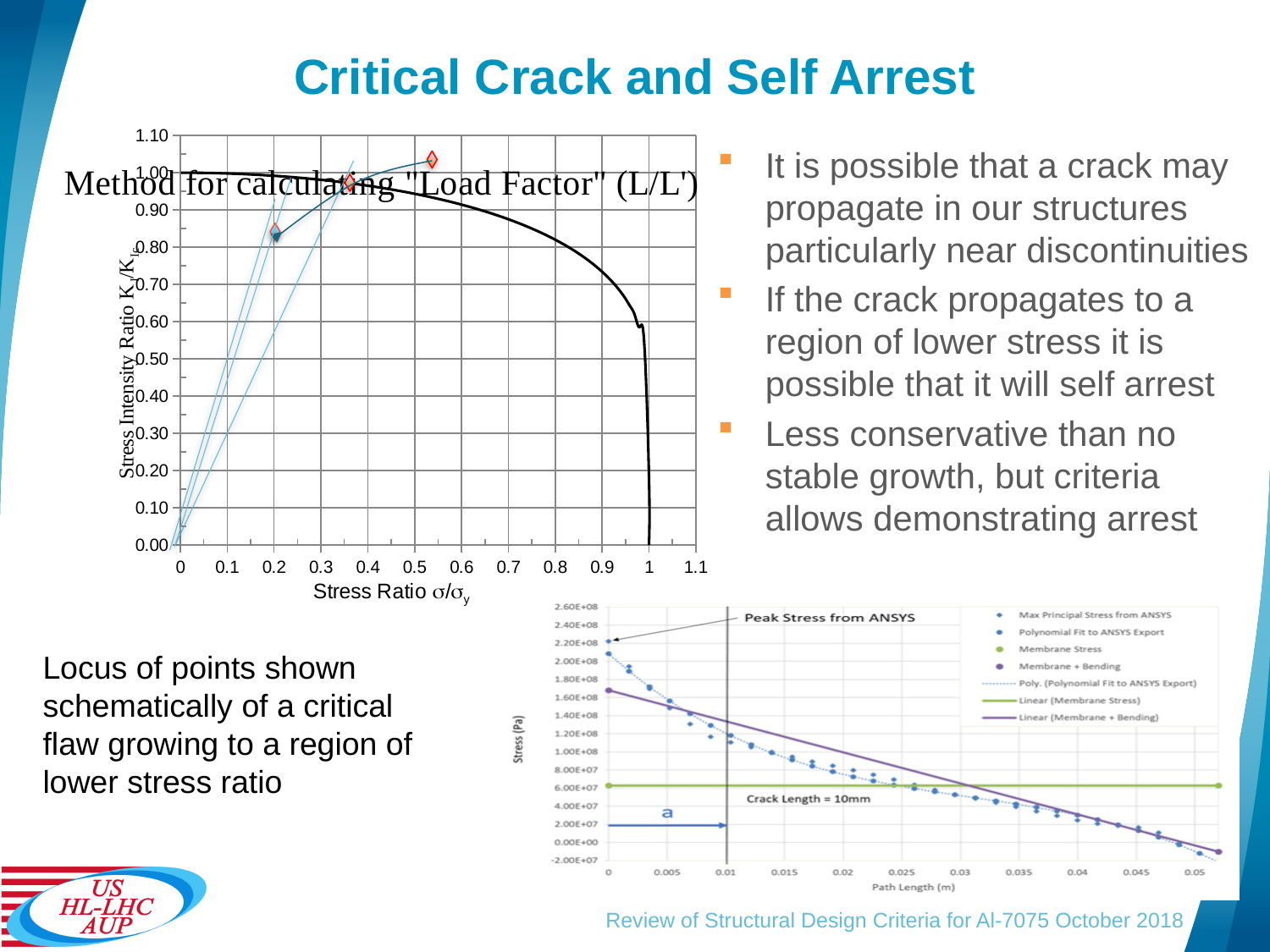
In the chart titled "Method for calculating "Load Factor" (L/L')", is the value of the thick black curve at a stress ratio of 0.9 greater or less than 0.60? greater In the bottom-right chart with the x axis "Path Length (m)", how many entries does the legend list? 7 In the chart titled "Method for calculating "Load Factor" (L/L')", what is the highest value shown on the y axis? 1.10 In the bottom-right chart with the x axis "Path Length (m)", at a path length of 0, which is larger: the Max Principal Stress from ANSYS or the Membrane Stress? Max Principal Stress from ANSYS In the bottom-right chart with the x axis "Path Length (m)", what is the label of the y axis? Stress (Pa) What kind of chart is the chart titled "Method for calculating "Load Factor" (L/L')"? line chart In the chart titled "Method for calculating "Load Factor" (L/L')", does the thick black curve rise or fall as the stress ratio increases? fall In the bottom-right chart with the x axis "Path Length (m)", is the Membrane Stress line greater or less than 1.00E+08? less In the bottom-right chart with the x axis "Path Length (m)", does the Linear (Membrane + Bending) line rise or fall as path length increases? fall In the chart titled "Method for calculating "Load Factor" (L/L')", what is the label of the x axis? Stress Ratio σ/σy In the chart titled "Method for calculating "Load Factor" (L/L')", how many diamond markers are plotted? 3 In the bottom-right chart with the x axis "Path Length (m)", is the Max Principal Stress from ANSYS at a path length of 0 greater or less than 2.00E+08? greater